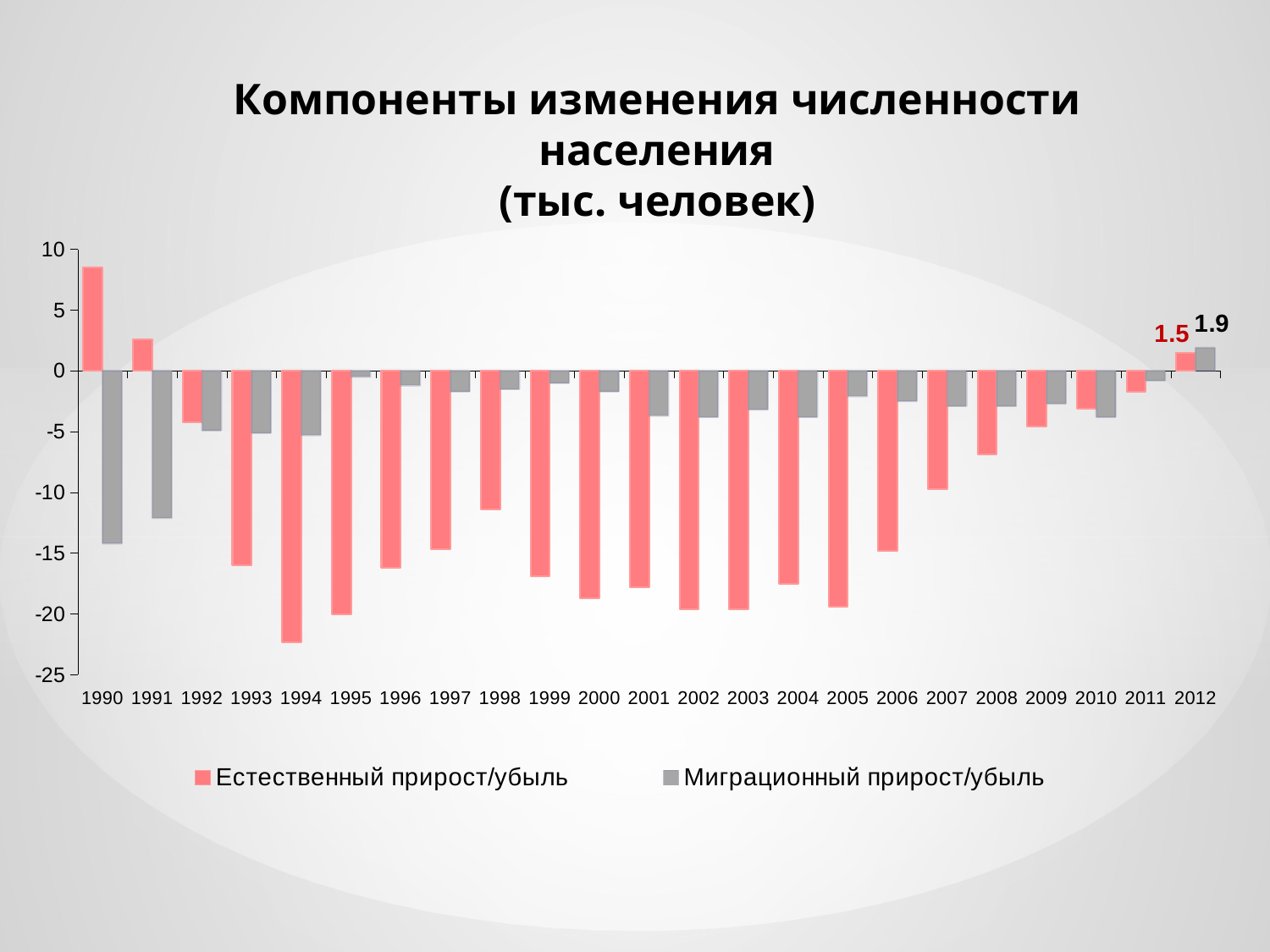
Is the value of Естественный прирост/убыль for 1994 greater or less than -20? less What is the value of Миграционный прирост/убыль for 2012? 1.9 What is the value of Естественный прирост/убыль for 2012? 1.5 How many series does the legend list? 2 In which year is Естественный прирост/убыль at its lowest? 1994 How many years are shown on the x axis? 23 In 2012, which series has the larger value, Естественный прирост/убыль or Миграционный прирост/убыль? Миграционный прирост/убыль What is the difference between the Миграционный прирост/убыль and Естественный прирост/убыль values in 2012? 0.4 In which year is Миграционный прирост/убыль at its lowest? 1990 In which year is Естественный прирост/убыль at its highest? 1990 Does Естественный прирост/убыль rise or fall from 2005 to 2012? rise What kind of chart is shown on the slide? bar chart